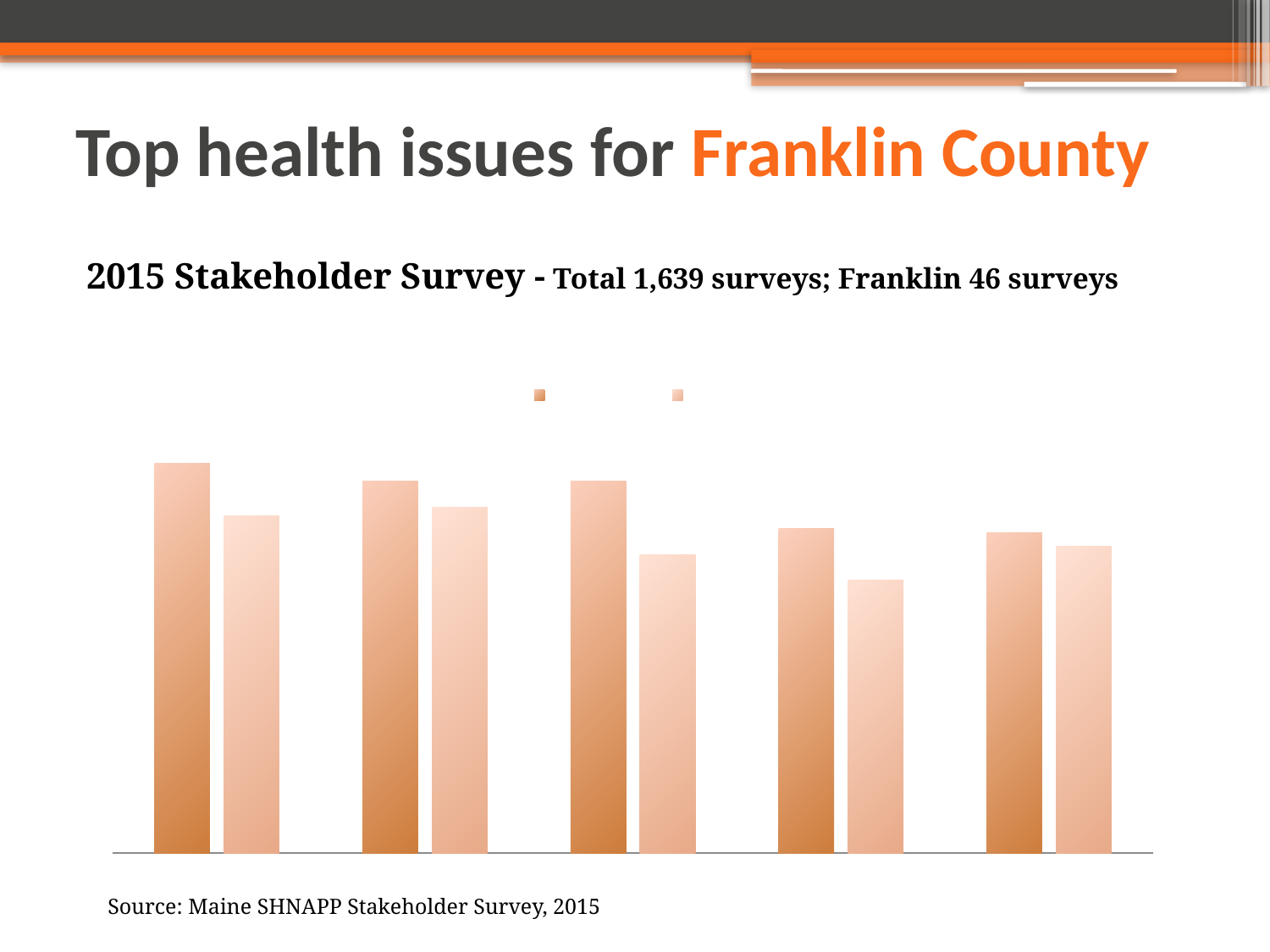
How many series does the chart's legend list? 2 Which group of bars contains the tallest bar in the chart? the leftmost group What kind of chart is shown on the slide? bar chart How many bars are plotted in total in the chart? 10 How many groups of bars are plotted in the chart? 5 Which group of bars contains the shortest bar in the chart? the fourth group from the left In each group of bars, is the darker orange bar or the lighter orange bar taller? the darker orange bar Are the bars in the chart vertical or horizontal? vertical In the leftmost group, which bar is taller, the darker one or the lighter one? the darker one Do the darker orange bars generally rise or fall from left to right across the chart? fall What colours are the two series in the chart? dark orange and light orange